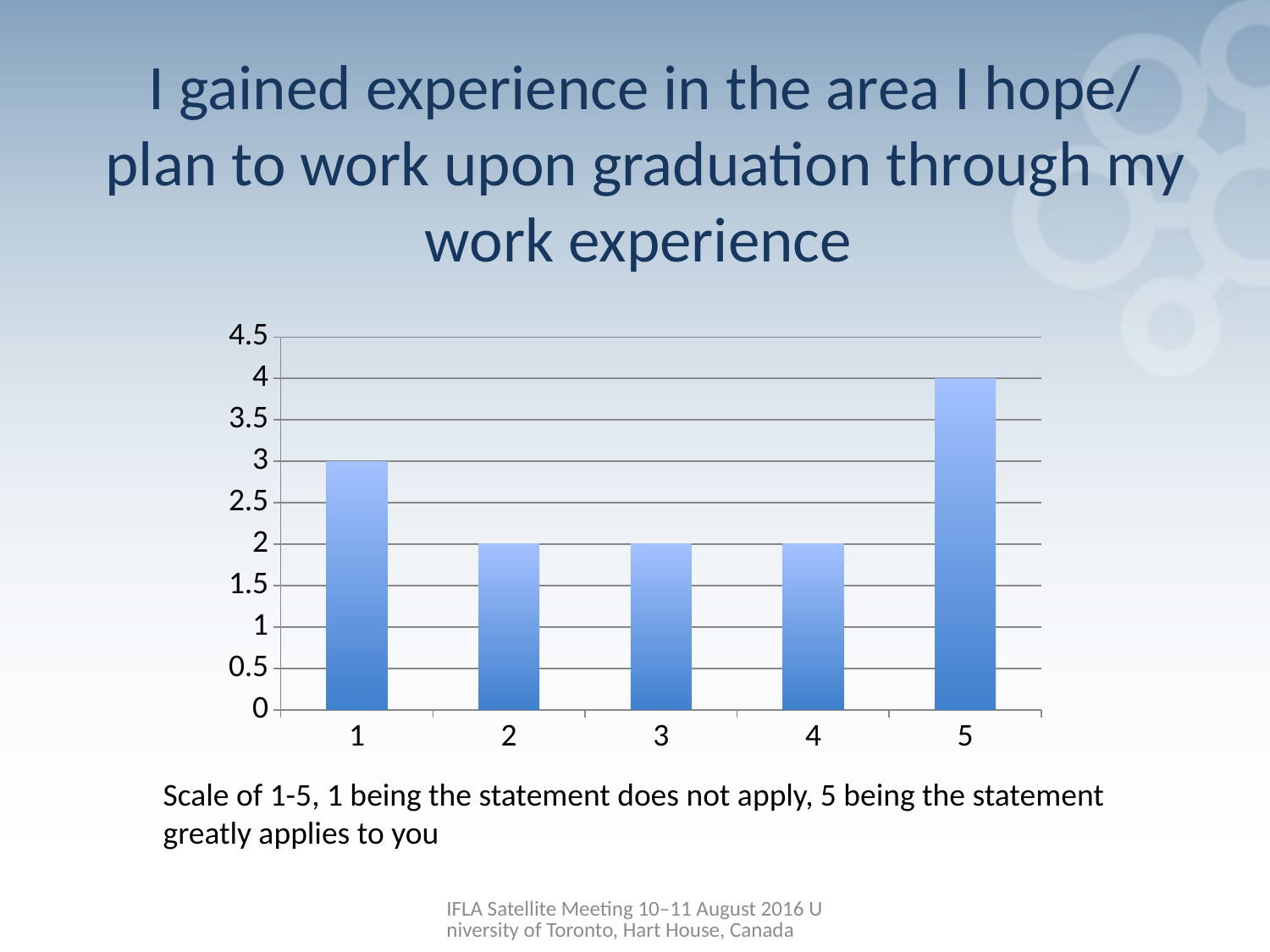
What is the value for category 3? 2 Which category has the highest value? 5 What kind of chart is shown on the slide? bar chart What is the difference between the values for category 1 and category 2? 1 How many categories are shown on the x axis? 5 What is the difference between the values for category 5 and category 1? 1 Which is larger, the value for category 1 or the value for category 4? category 1 Is the value for category 2 greater or less than 2.5? less Is the value for category 5 greater or less than 3.5? greater What is the highest value shown on the y axis? 4.5 What is the value for category 1? 3 What is the value for category 5? 4